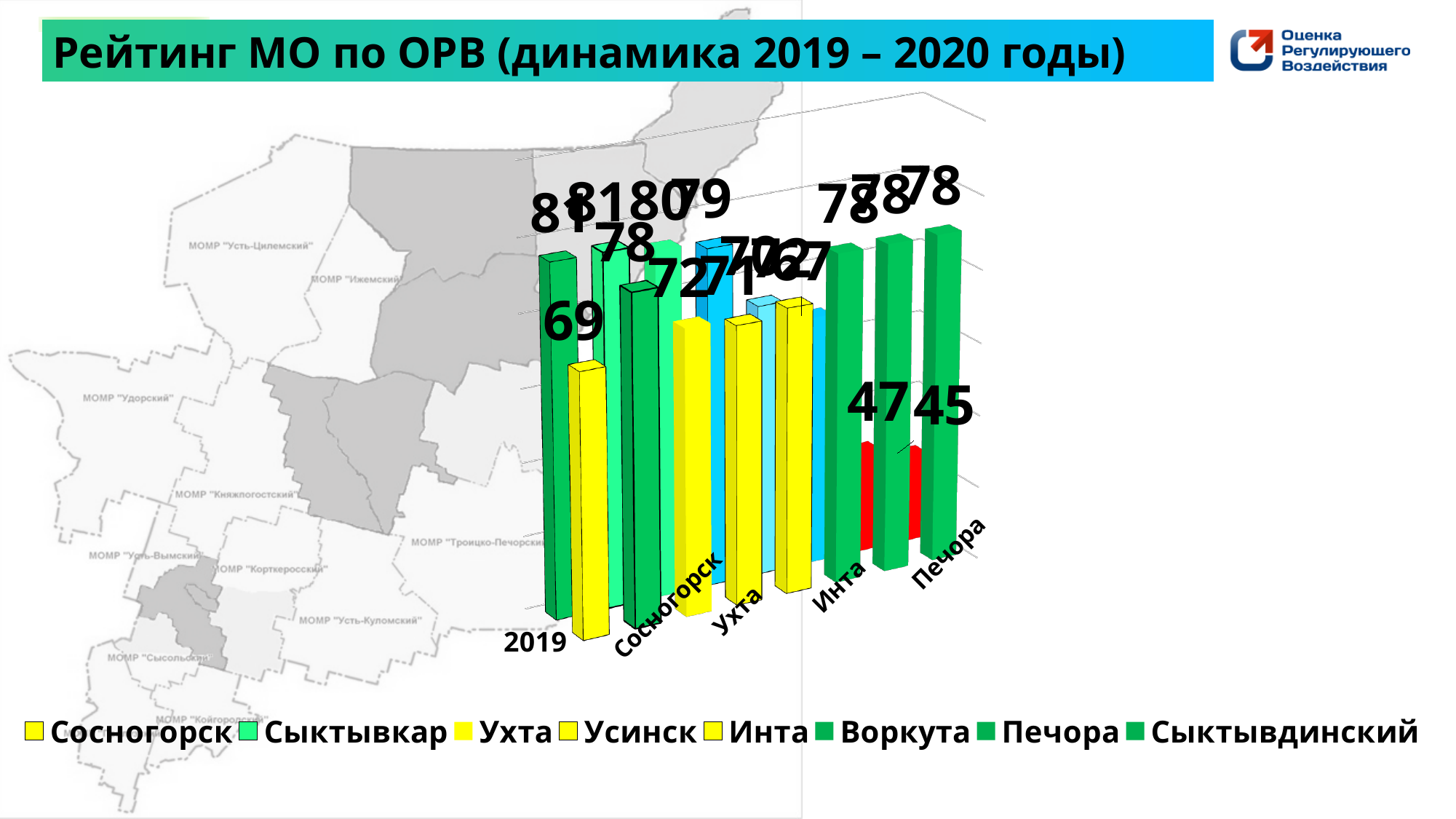
What is the difference between the two values labeled on the red bars, 47 and 45? 2 Which is larger, the value labeled 69 or the value labeled 78? 78 Which series is listed first in the chart legend? Сосногорск What is the lowest data label shown on the chart? 45 How many series does the legend list? 8 What is the title of the chart on the slide? Рейтинг МО по ОРВ (динамика 2019 – 2020 годы) What kind of chart is shown on the slide? bar chart What values are labeled on the two red bars in the chart? 47 and 45